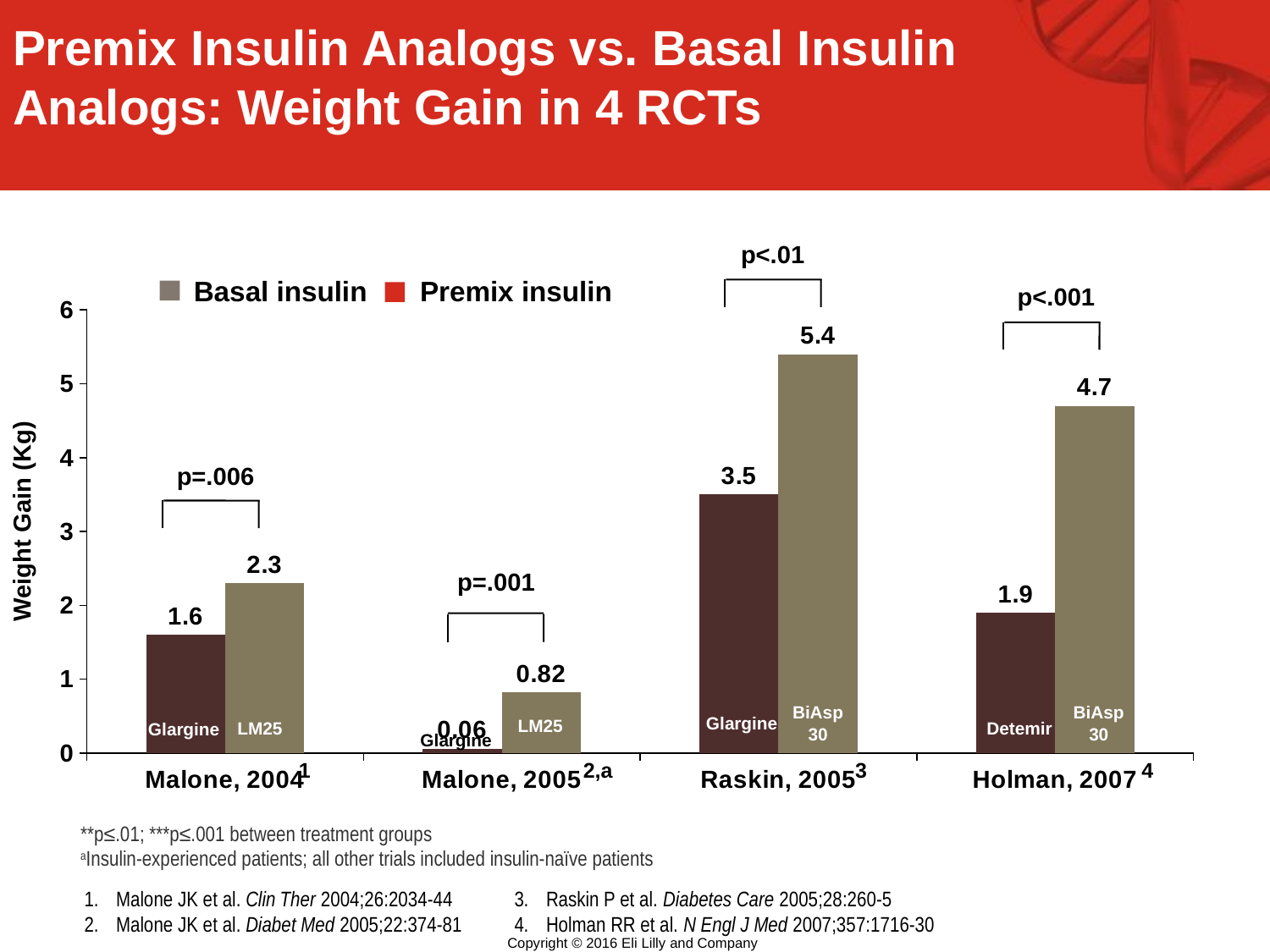
Which study shows the lowest weight gain for Basal insulin? Malone, 2005 How many series does the legend list? 2 What is the weight gain for Premix insulin in Raskin, 2005? 5.4 What is the weight gain for Premix insulin (LM25) in Malone, 2004? 2.3 What is the weight gain for Basal insulin in Malone, 2005? 0.06 How many studies (categories) are shown on the x axis? 4 Which study shows the highest weight gain for Premix insulin? Raskin, 2005 What is the difference in weight gain between Premix insulin and Basal insulin in Raskin, 2005? 1.9 What kind of chart is shown on the slide? Bar chart Which is larger: the Basal insulin weight gain in Raskin, 2005 or the Premix insulin weight gain in Malone, 2004? Basal insulin in Raskin, 2005 What is the weight gain for Basal insulin (Detemir) in Holman, 2007? 1.9 What is the difference in weight gain between Premix insulin and Basal insulin in Holman, 2007? 2.8